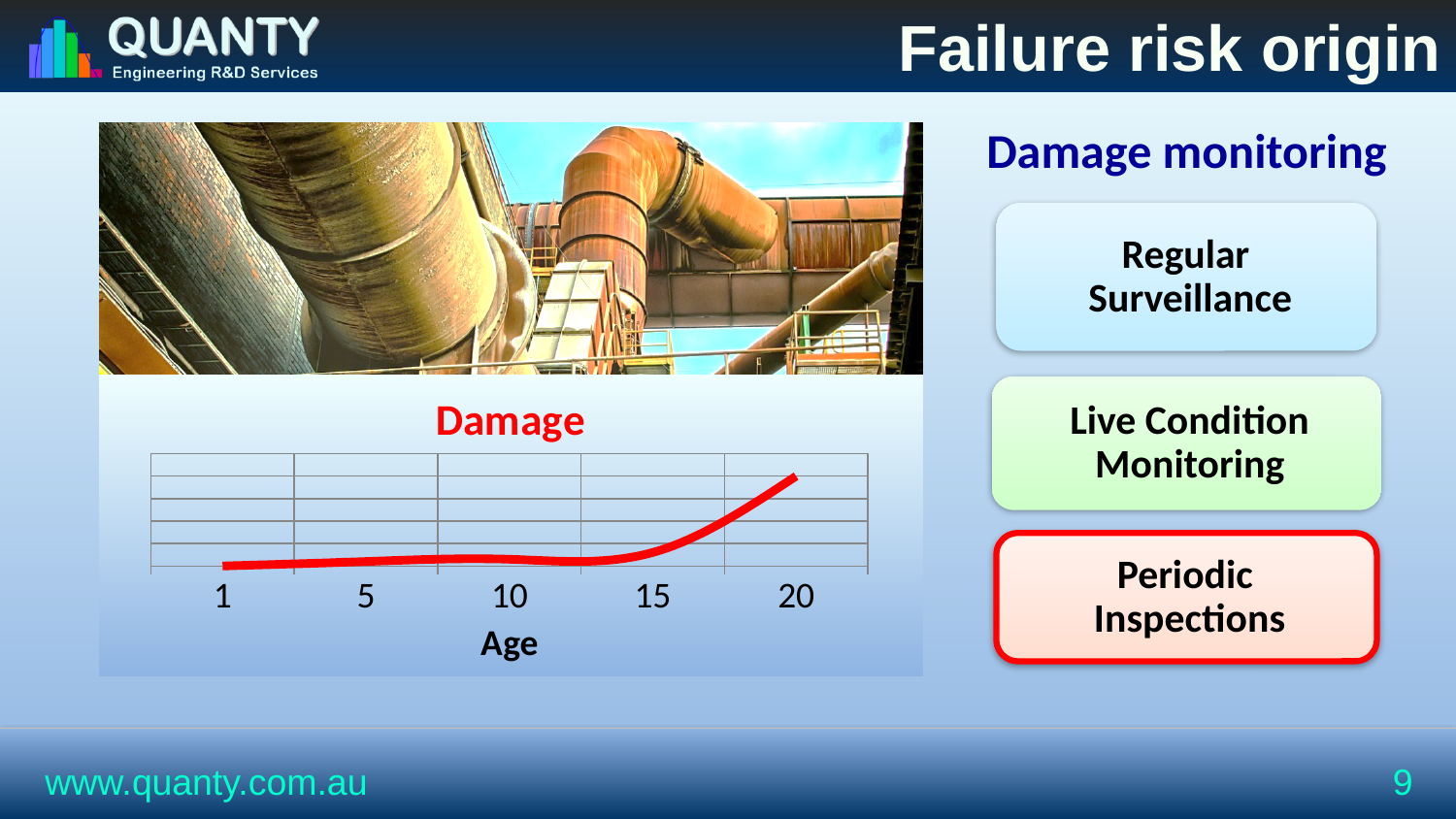
At which age shown on the x axis is the damage value lowest? 1 What kind of chart is shown on the slide? line chart Which has the larger damage value, age 15 or age 1? age 15 At which age shown on the x axis is the damage value highest? 20 What is the label of the x axis of the Damage chart? Age What is the largest age value labelled on the x axis of the Damage chart? 20 Which has the larger damage value, age 20 or age 5? age 20 How many age tick labels are shown on the x axis of the Damage chart? 5 What is the title of the chart? Damage Does the damage value rise or fall as age increases along the x axis? rise